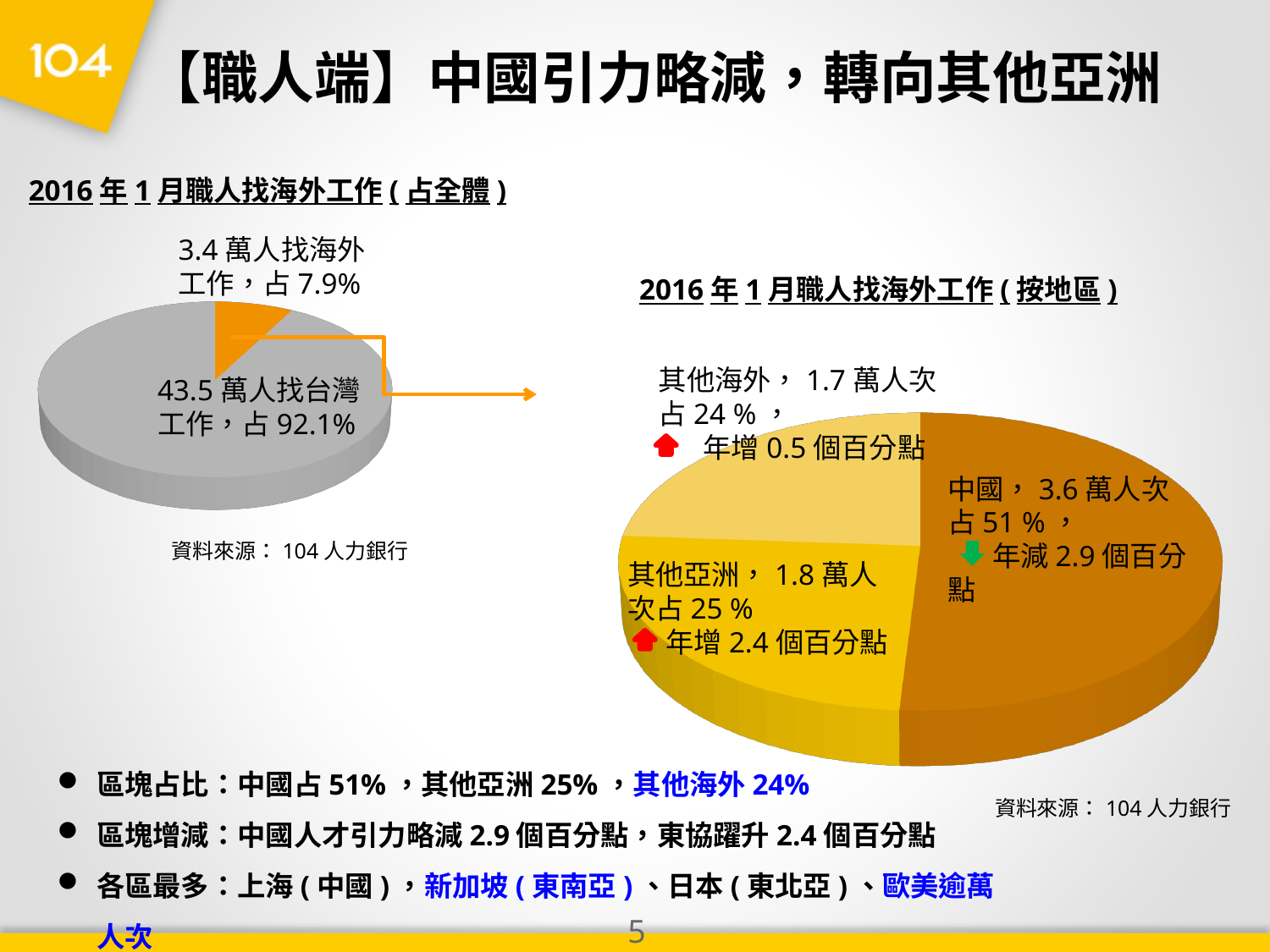
In the right pie chart (按地區), how many slices does the pie have? 3 In the right pie chart (按地區), which region has the largest share? 中國 In the right pie chart (按地區), what share does 中國 account for? 51% In the right pie chart (按地區), by how many percentage points did the share of 其他亞洲 change year over year? 年增 2.4 個百分點 What type of chart is used on the left side of the slide (2016年1月職人找海外工作(占全體))? pie chart In the left pie chart (占全體), how many people (in 萬人) looked for overseas work? 3.4 萬人 In the left pie chart (占全體), what share of people looked for overseas work (找海外工作)? 7.9% In the left pie chart (占全體), how many people (in 萬人) looked for work in Taiwan? 43.5 萬人 In the right pie chart (按地區), which region has the smallest share? 其他海外 In the right pie chart (按地區), what is the difference in percentage points between the share of 中國 and the share of 其他亞洲? 26 In the right pie chart (按地區), how many 萬人次 are attributed to 其他亞洲? 1.8 萬人次 In the left pie chart (占全體), what share of people looked for work in Taiwan (找台灣工作)? 92.1%